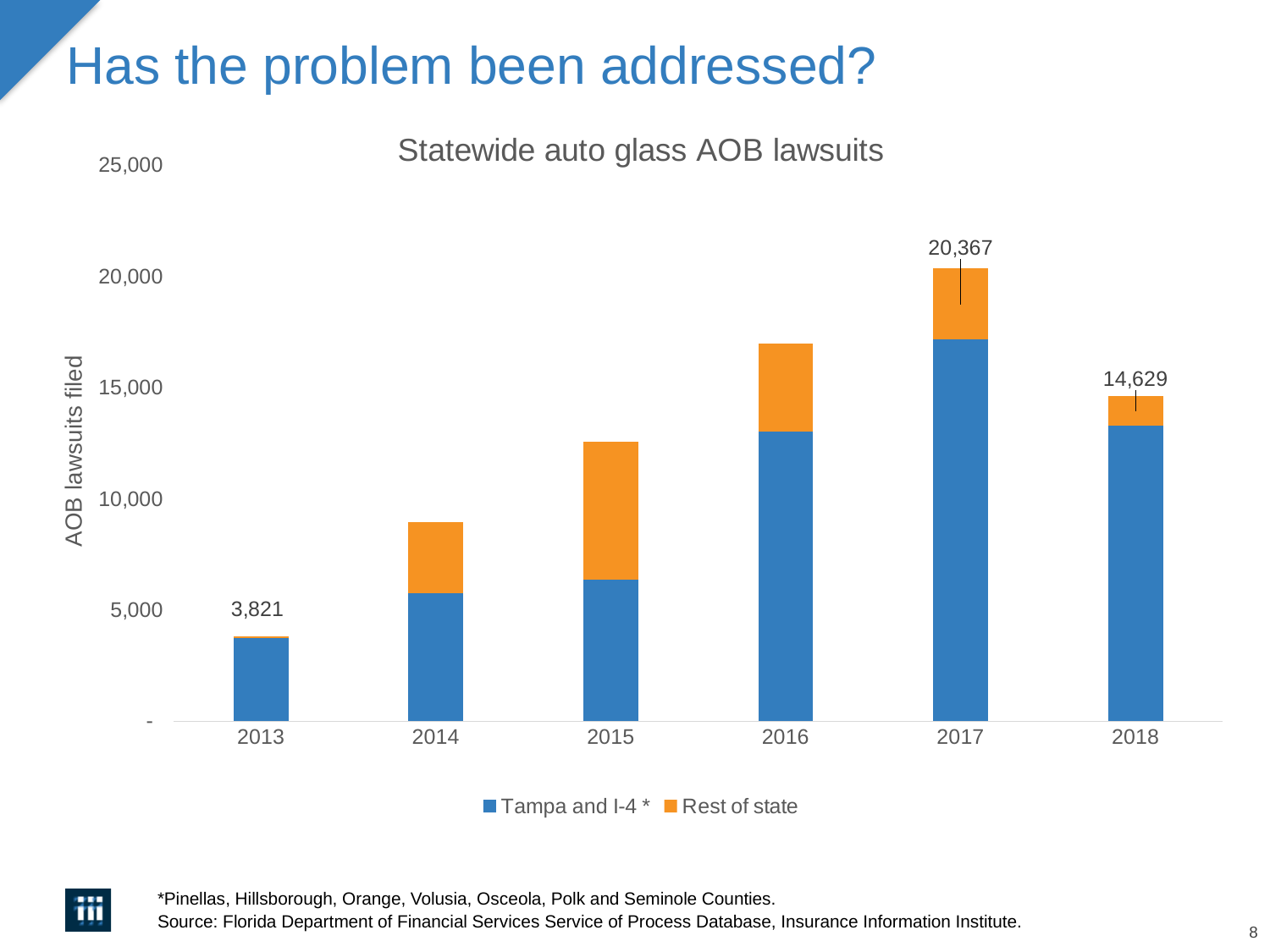
Is the total number of lawsuits in 2016 greater or less than 15,000? greater What is the total number of AOB lawsuits filed in 2018? 14,629 What is the title of the chart? Statewide auto glass AOB lawsuits How many years are shown on the x axis of the chart? 6 Which year has the highest total number of AOB lawsuits? 2017 What kind of chart is shown on the slide? bar chart What is the difference between the total lawsuits in 2017 and in 2018? 5,738 What is the total number of AOB lawsuits filed in 2017? 20,367 Which year has the lowest total number of AOB lawsuits? 2013 What is the total number of AOB lawsuits filed in 2013? 3,821 How many series does the legend list? 2 Which series is shown in orange in the chart? Rest of state